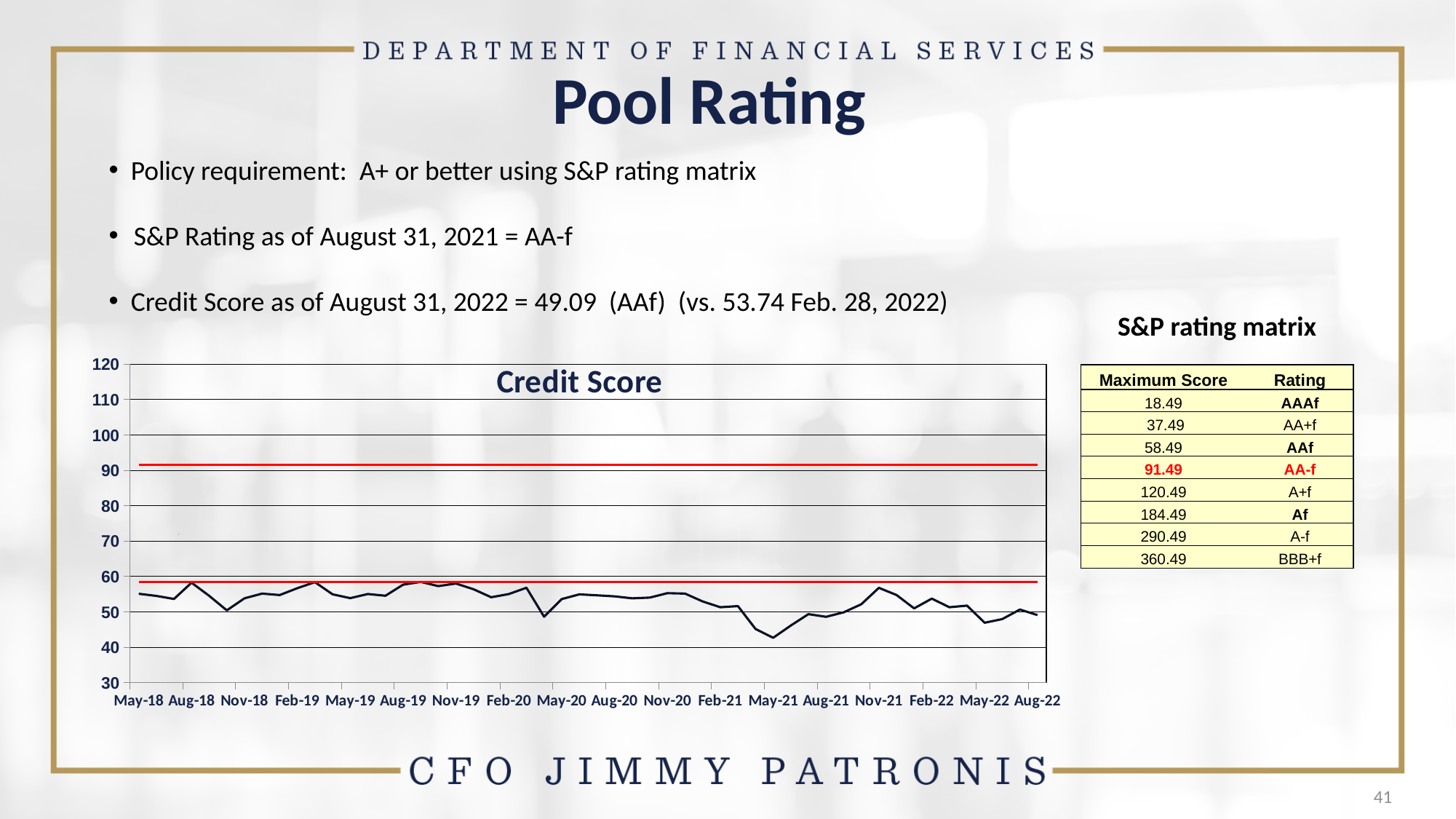
Between Feb-21 and May-21, does the credit score line rise or fall? fall Which has the higher credit score on the chart, May-21 or Nov-21? Nov-21 Which x-axis date has the lowest credit score on the chart? May-21 How many red horizontal lines are drawn on the Credit Score chart? 2 How many date labels are shown along the x axis of the Credit Score chart? 18 Is the credit score for Aug-22 greater or less than 60? less Is the credit score for Nov-21 greater or less than 50? greater Is the credit score for May-21 greater or less than 50? less What kind of chart is the Credit Score chart? line chart What is the title of the chart on the slide? Credit Score